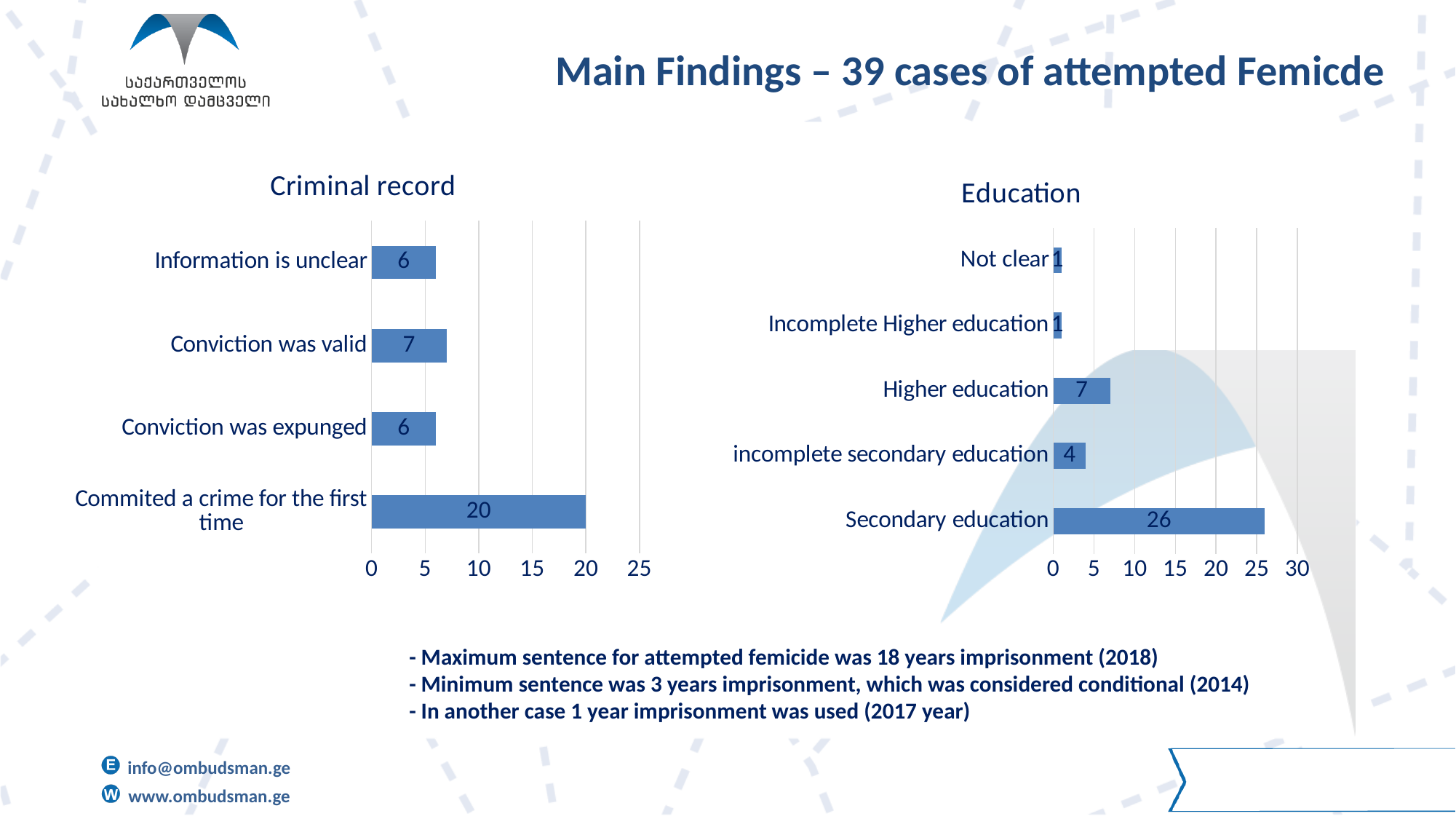
In the Criminal record chart, what is the value for Commited a crime for the first time? 20 In the Education chart, what is the value for incomplete secondary education? 4 In the Criminal record chart, what is the value for Conviction was valid? 7 In the Criminal record chart, which category has the highest value? Commited a crime for the first time What kind of chart is the Education chart? Bar chart In the Education chart, what is the difference between Secondary education and Higher education? 19 In the Education chart, which is larger: Higher education or incomplete secondary education? Higher education In the Criminal record chart, how many categories are shown? 4 In the Criminal record chart, what is the total of all the values shown? 39 In the Criminal record chart, what is the difference between Commited a crime for the first time and Conviction was valid? 13 In the Education chart, what is the value for Secondary education? 26 In the Education chart, which category has the highest value? Secondary education